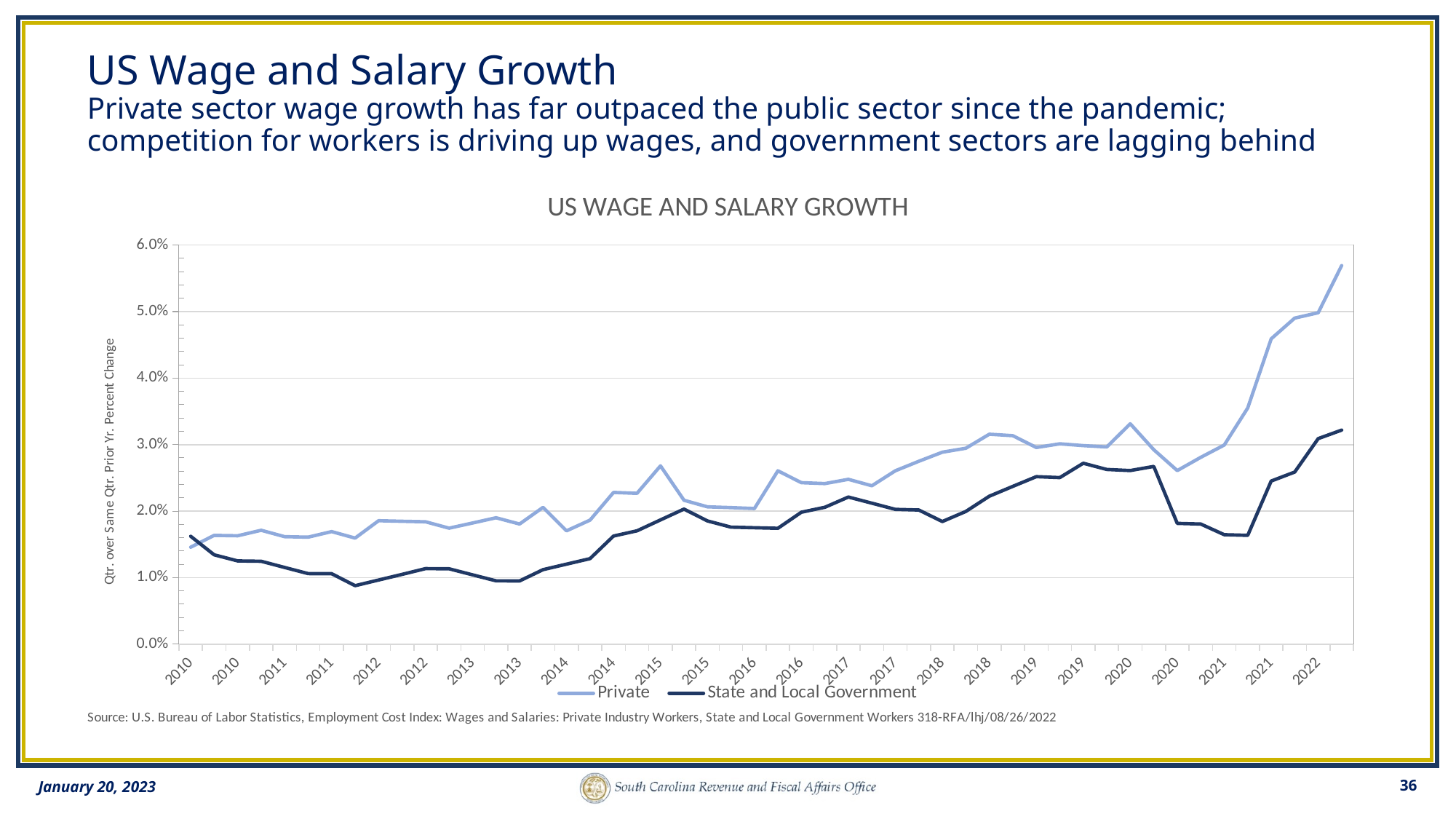
Is the first 2010 value for the Private series greater or less than 2.0%? less Is the final 2022 value for the State and Local Government series greater or less than 2.0%? greater At the last point on the chart (2022), which series is higher, Private or State and Local Government? Private How many series does the legend list? 2 What kind of chart is shown on the slide? line chart Which series reaches the highest value anywhere on the chart? Private What is the title of the chart? US WAGE AND SALARY GROWTH Is the lowest value of the State and Local Government series greater or less than 1.0%? less Does the Private series rise or fall from 2021 to the end of 2022? rise Which series has the lowest value anywhere on the chart? State and Local Government What are the two series named in the legend? Private; State and Local Government